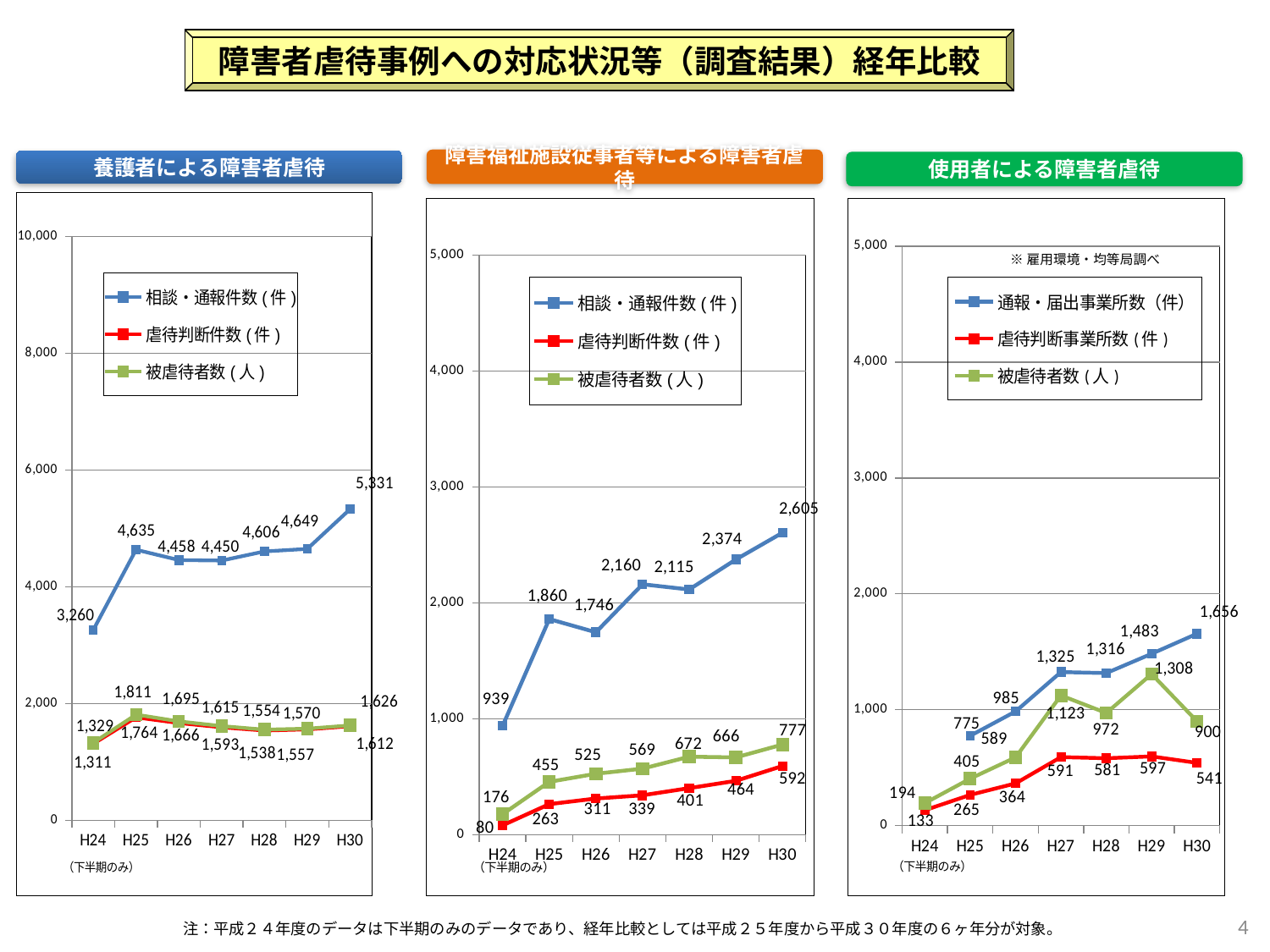
In the 養護者による障害者虐待 chart, what is the value of 相談・通報件数 for H30? 5,331 In the 養護者による障害者虐待 chart, what is the difference between 相談・通報件数 in H30 and H29? 682 In the 養護者による障害者虐待 chart, what is the value of 虐待判断件数 for H25? 1,764 In the 障害福祉施設従事者等による障害者虐待 chart, is 相談・通報件数 for H26 or H27 larger? H27 In the 養護者による障害者虐待 chart, which year has the lowest 相談・通報件数? H24 How many series does the legend of the 使用者による障害者虐待 chart list? 3 In the 障害福祉施設従事者等による障害者虐待 chart, which year has the highest 相談・通報件数? H30 In the 障害福祉施設従事者等による障害者虐待 chart, what is the value of 被虐待者数 for H30? 777 What type of chart is the 障害福祉施設従事者等による障害者虐待 chart? Line chart How many years are plotted on the x axis of the 養護者による障害者虐待 chart? 7 In the 使用者による障害者虐待 chart, what is the difference between 虐待判断事業所数 in H29 and H30? 56 In the 使用者による障害者虐待 chart, what is the value of 被虐待者数 for H29? 1,308